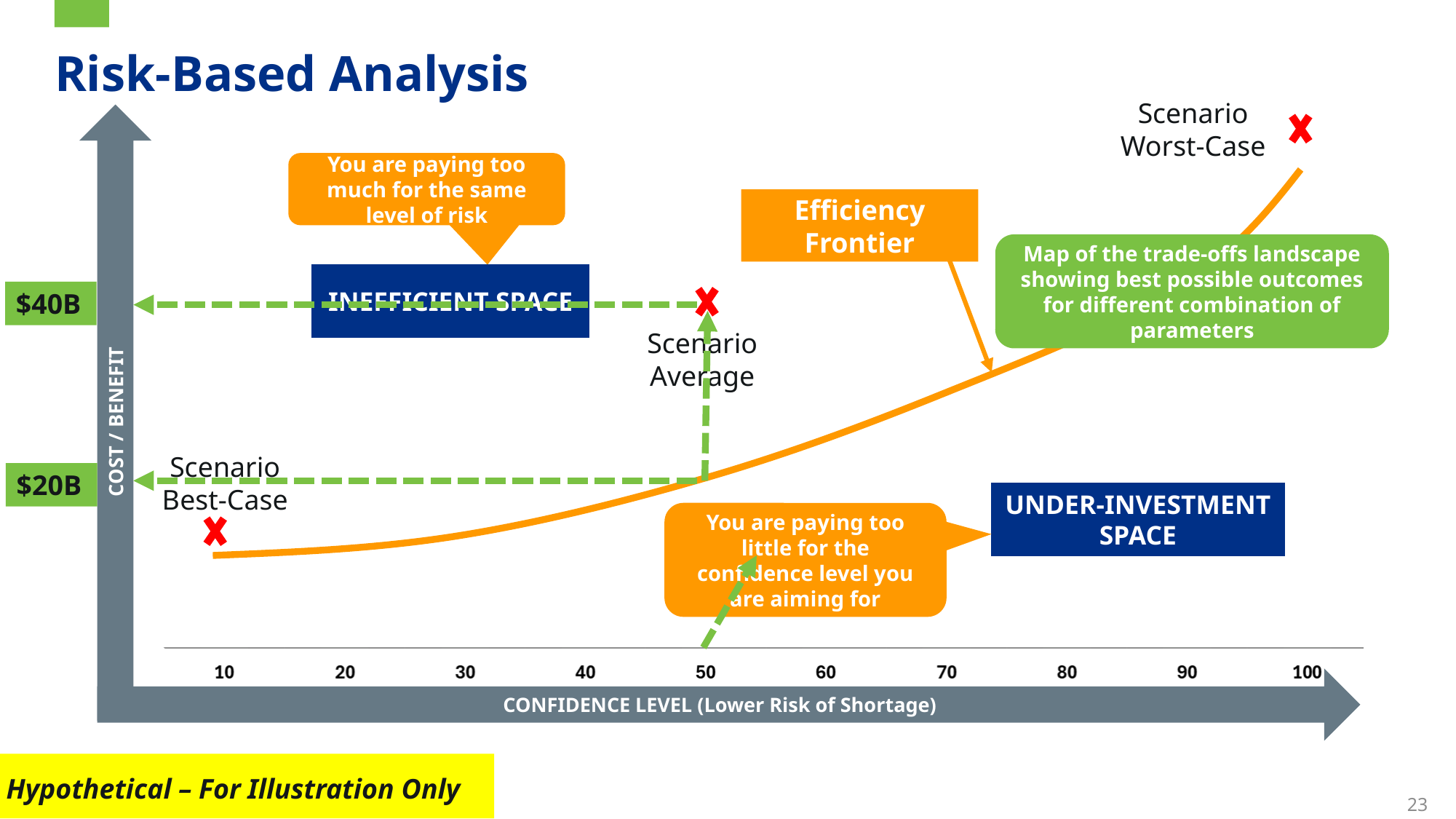
What kind of chart is shown on the slide? line chart Which scenario has the lowest cost? Scenario Best-Case What does the orange curve on the chart represent? Efficiency Frontier Which scenario has the highest confidence level? Scenario Worst-Case What cost does the Efficiency Frontier show at a confidence level of 50? $20B Is the cost for Scenario Worst-Case greater or less than $40B? greater How many scenario points are marked on the chart? 3 What is the label of the horizontal axis? CONFIDENCE LEVEL (Lower Risk of Shortage) How much more does Scenario Average cost than the Efficiency Frontier at a confidence level of 50? $20B Does the Efficiency Frontier rise or fall as the confidence level increases? rises At what confidence level is Scenario Average plotted? 50 What cost value does Scenario Average correspond to on the vertical axis? $40B